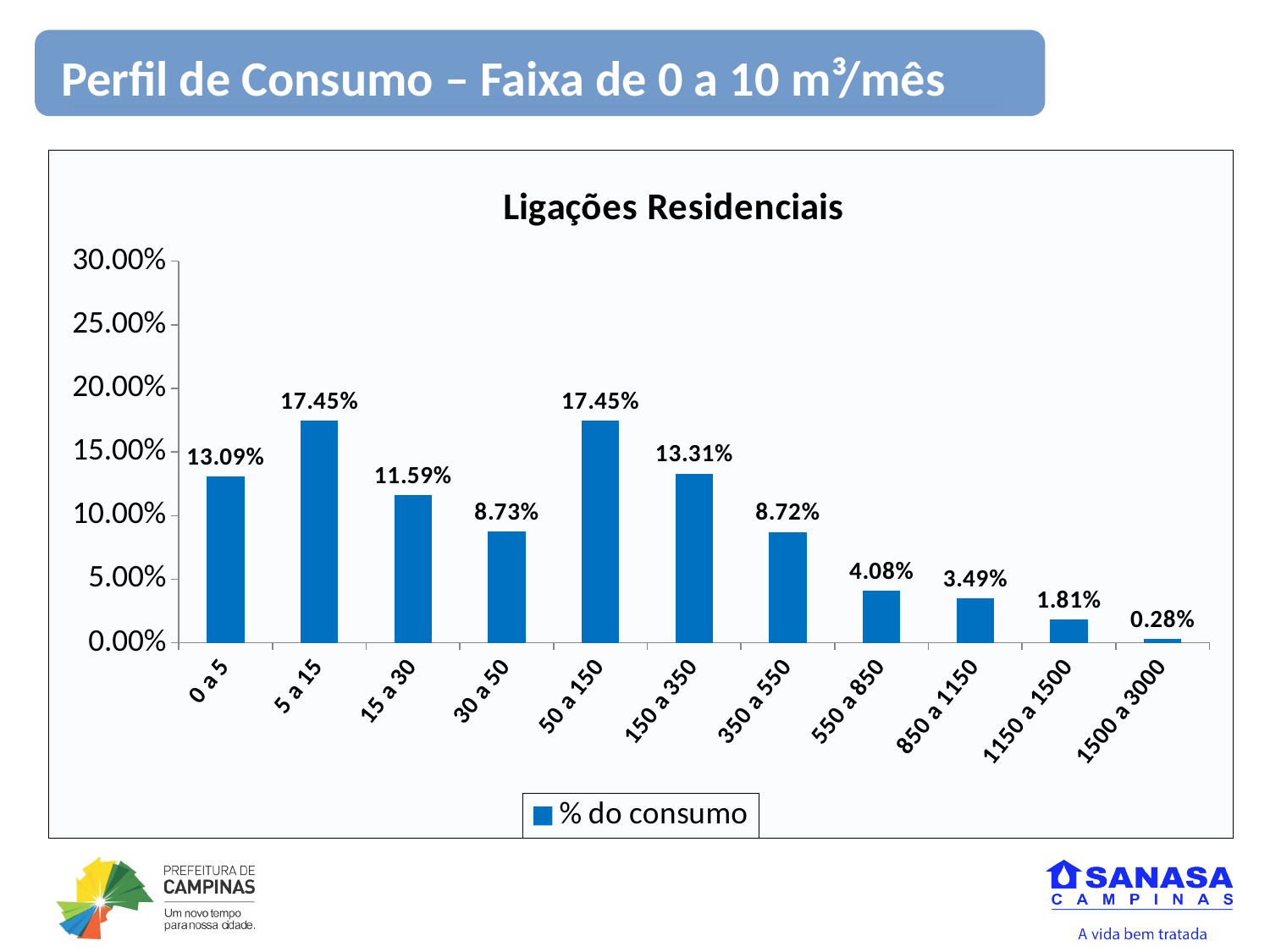
What kind of chart is shown? bar chart What is the value for the 0 a 5 category? 13.09% What is the difference between the values for 5 a 15 and 15 a 30? 5.86% Which category has the lowest value? 1500 a 3000 How many categories are shown on the x axis? 11 How many series does the legend list? 1 What is the title of the chart? Ligações Residenciais Is the value for 50 a 150 greater or less than 15.00%? greater What is the difference between the values for 150 a 350 and 350 a 550? 4.59% Which is larger, the value for 30 a 50 or the value for 850 a 1150? 30 a 50 What is the value for the 550 a 850 category? 4.08% What is the value for the 1150 a 1500 category? 1.81%